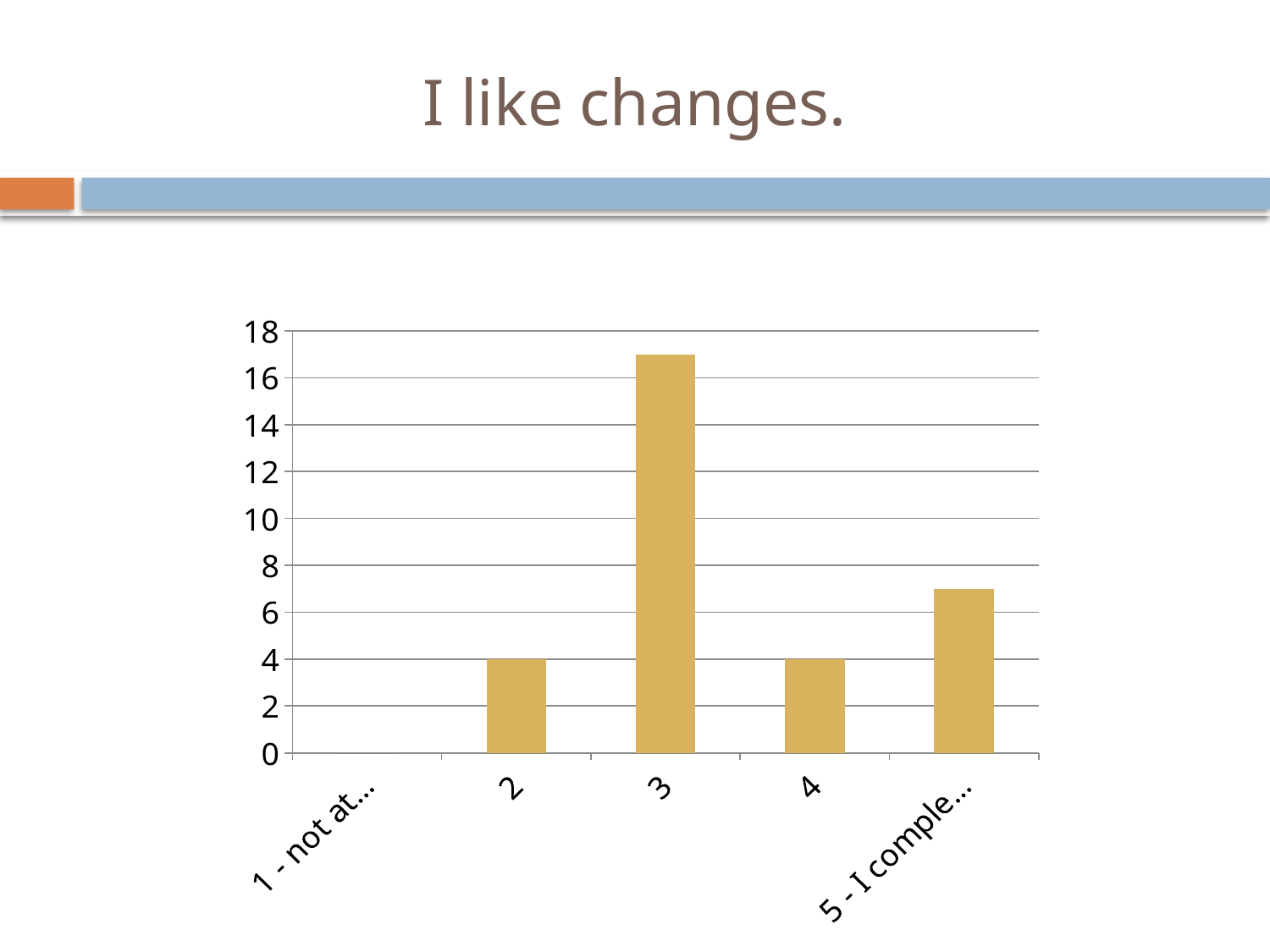
Which category has the highest bar? 3 How many categories are shown on the x axis of the chart? 5 Is the value for category 3 greater or less than 16? greater What type of chart is shown on the slide? bar chart Which is larger, the value for category 3 or the value for the category "5 - I comple..."? 3 What is the value for category 2? 4 What is the title of the slide containing the chart? I like changes. What is the difference between the values for category 2 and category 4? 0 What is the value for category 4? 4 Is the value for category 3 greater or less than 18? less Is the value for the category "5 - I comple..." greater or less than 6? greater